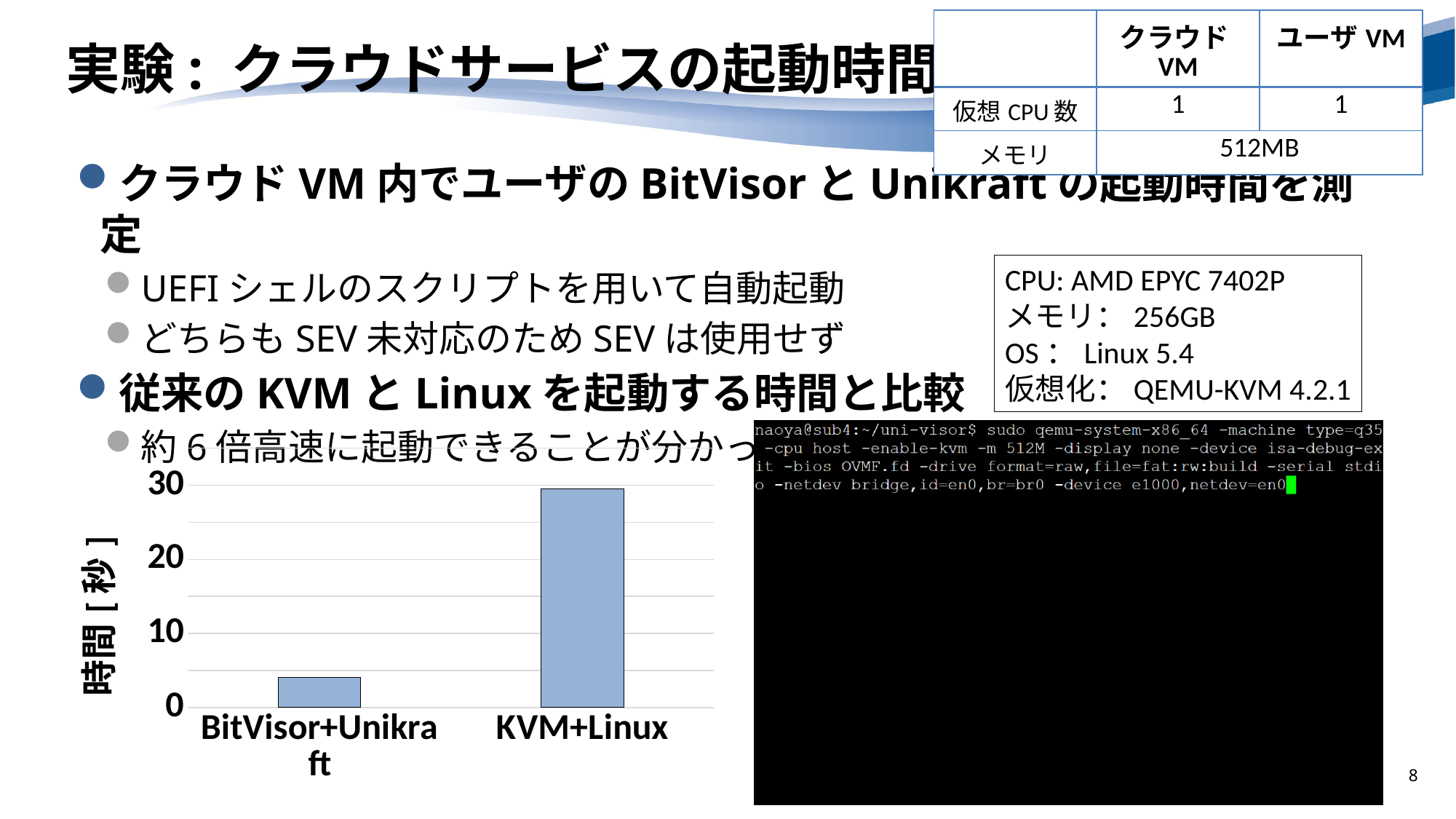
Which category has the lowest value in the bar chart? BitVisor+Unikraft What is the highest tick value shown on the y axis of the bar chart? 30 How many categories are plotted in the bar chart? 2 Which is larger, the value for BitVisor+Unikraft or the value for KVM+Linux? KVM+Linux Which category has the highest value in the bar chart? KVM+Linux What is the label of the y axis of the bar chart? 時間 [秒] Do the values rise or fall from left to right along the x axis? rise Is the value for BitVisor+Unikraft greater or less than 10? less Is the value for KVM+Linux greater or less than 20? greater What kind of chart is shown on the slide? bar chart